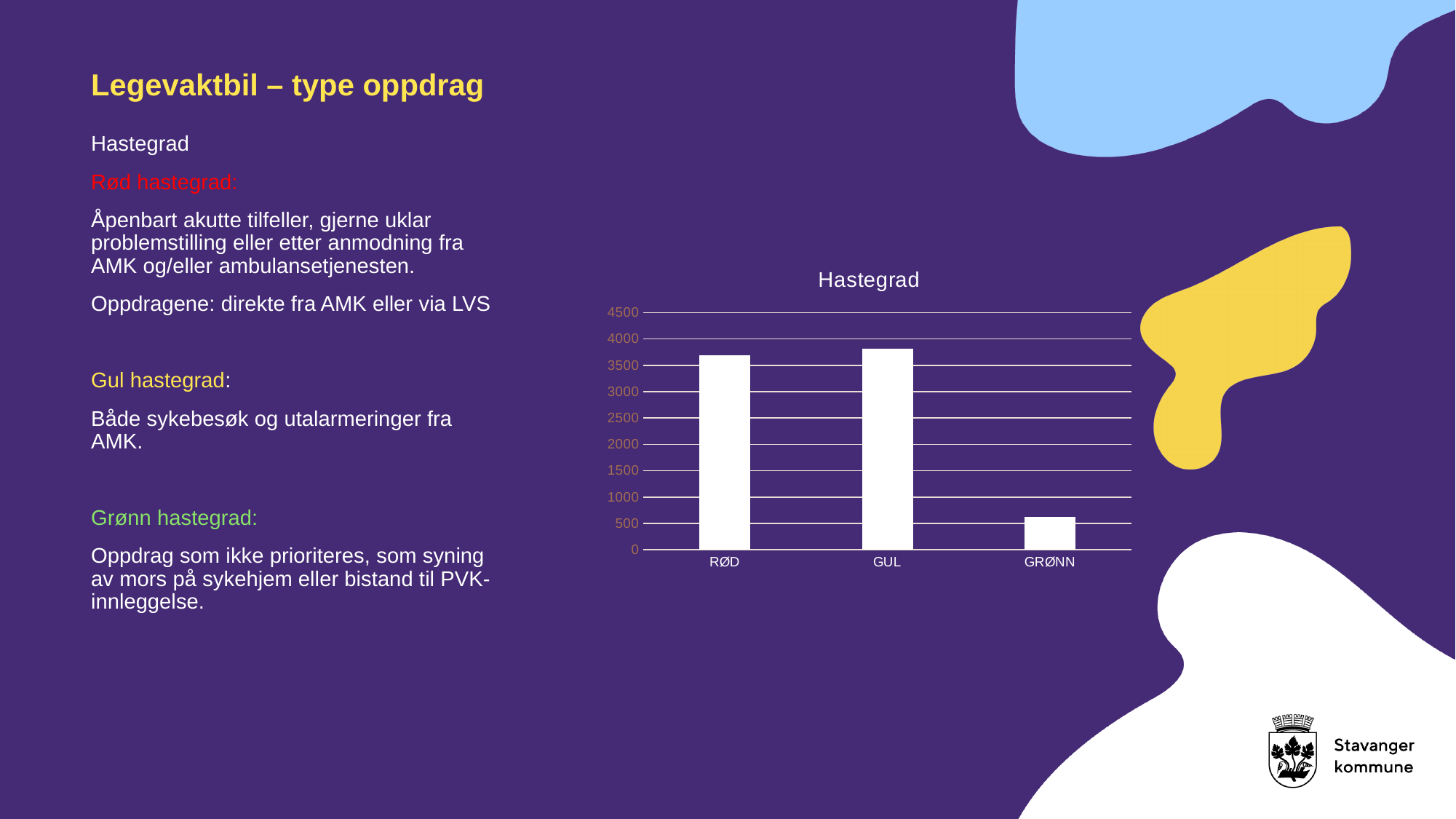
What kind of chart is shown on the slide? bar chart What is the title of the chart? Hastegrad Is the value for RØD greater or less than 3500? greater Which is larger, the value for GUL or the value for GRØNN? GUL Is the value for RØD greater or less than 4000? less What is the highest value shown on the y axis of the chart? 4500 Which category has the lowest value in the chart? GRØNN Is the value for GRØNN greater or less than 1000? less How many categories are shown on the x axis of the chart? 3